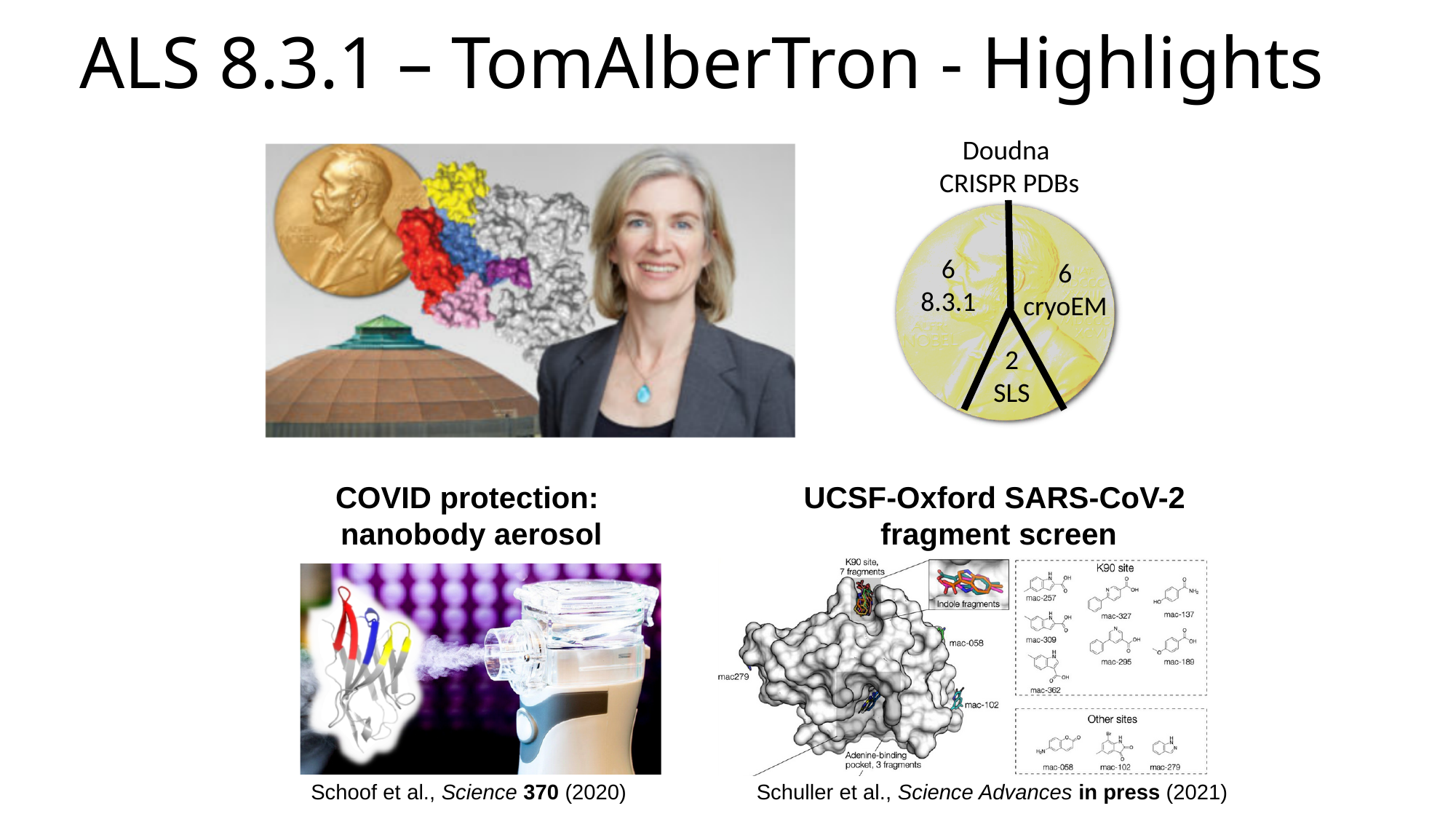
What is the title of the pie chart on the slide? Doudna CRISPR PDBs Which two categories in the Doudna CRISPR PDBs pie chart tie for the largest value? 8.3.1 and cryoEM How many slices does the Doudna CRISPR PDBs pie chart have? 3 Which slice of the Doudna CRISPR PDBs pie chart is the smallest? SLS In the Doudna CRISPR PDBs pie chart, how many more PDBs does cryoEM have than SLS? 4 What is the total number of Doudna CRISPR PDBs across all slices of the pie chart? 14 In the Doudna CRISPR PDBs pie chart, what is the value for SLS? 2 In the Doudna CRISPR PDBs pie chart, what is the value for cryoEM? 6 In the Doudna CRISPR PDBs pie chart, which is larger: 8.3.1 or SLS? 8.3.1 In the Doudna CRISPR PDBs pie chart, how many PDBs are attributed to 8.3.1? 6 What kind of chart is used to show the Doudna CRISPR PDBs? Pie chart What image is used as the background of the Doudna CRISPR PDBs pie chart? A Nobel Prize medal